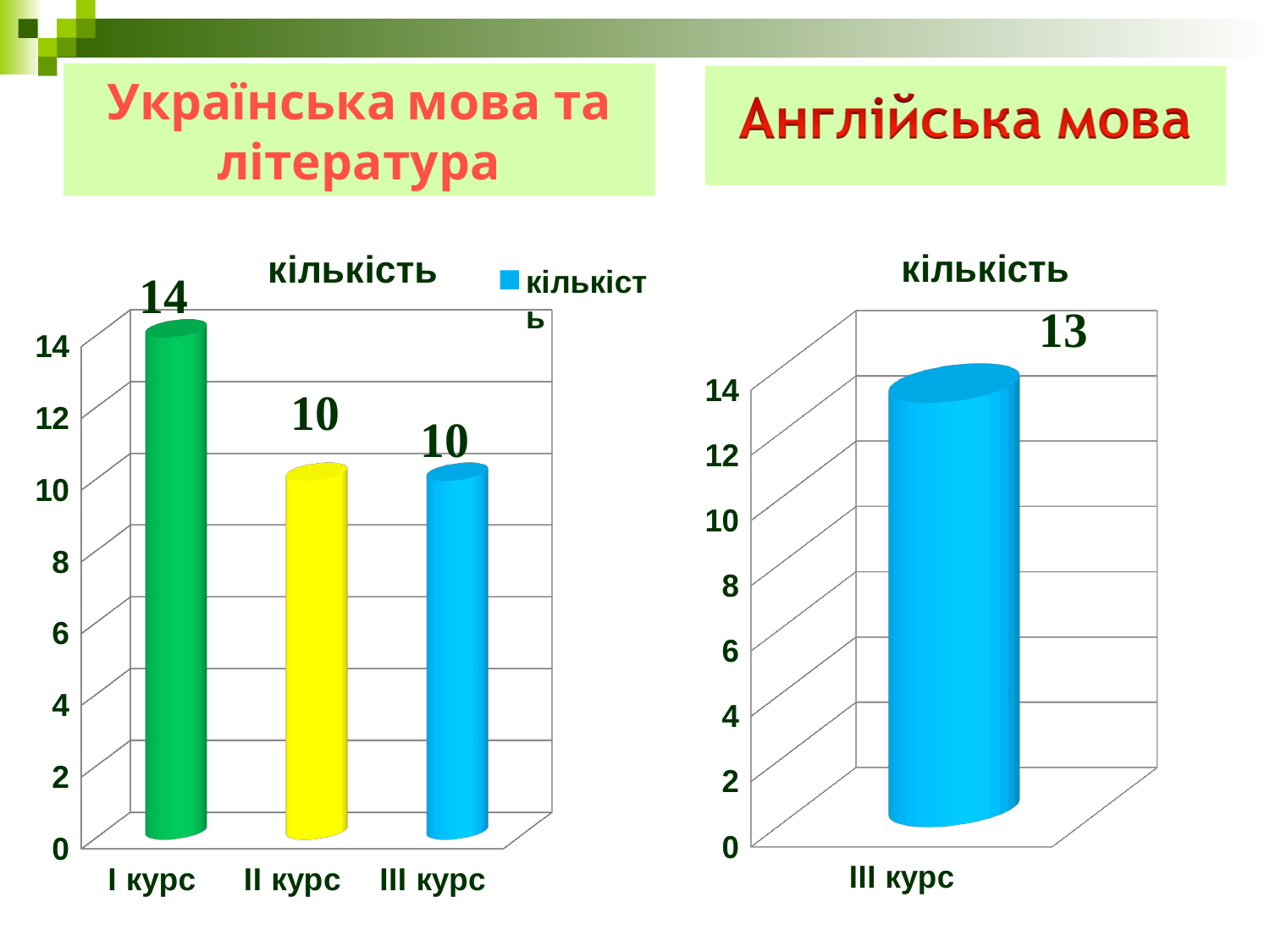
What kind of chart is the right chart (Англійська мова)? bar chart What is the title of the right chart (Англійська мова)? кількість How many categories are shown in the left chart (Українська мова та література)? 3 How many categories are shown in the right chart (Англійська мова)? 1 In the left chart (Українська мова та література), which is larger, the value for I курс or the value for III курс? I курс In the left chart (Українська мова та література), what is the value for II курс? 10 In the left chart (Українська мова та література), what is the value for I курс? 14 In the left chart (Українська мова та література), which category has the highest value? I курс In the left chart (Українська мова та література), what is the value for III курс? 10 How many series does the legend of the left chart (Українська мова та література) list? 1 In the left chart (Українська мова та література), what is the difference between the values for I курс and II курс? 4 In the right chart (Англійська мова), what is the value for III курс? 13